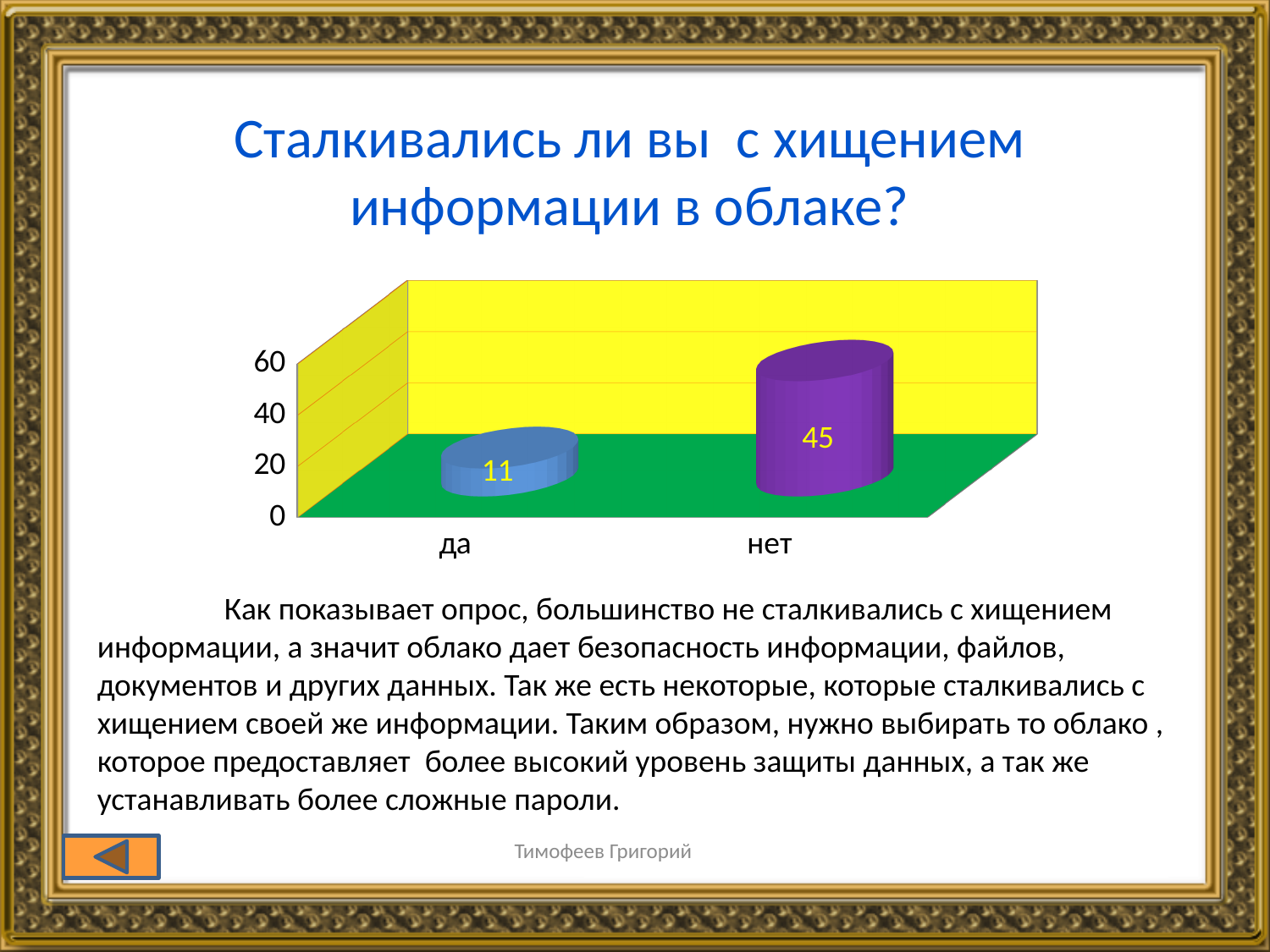
What is the difference between the values for "нет" and "да"? 34 Is the value for "да" greater or less than 20? less What is the total of the two values shown in the chart? 56 Is the value for "нет" greater or less than 40? greater What kind of chart is shown on the slide? bar chart Which is larger, the value for "да" or the value for "нет"? нет What is the value for "нет"? 45 What is the title of the chart on the slide? Сталкивались ли вы с хищением информации в облаке? What is the value for "да"? 11 How many categories are shown on the x axis? 2 Which category has the highest value? нет Which category has the lowest value? да